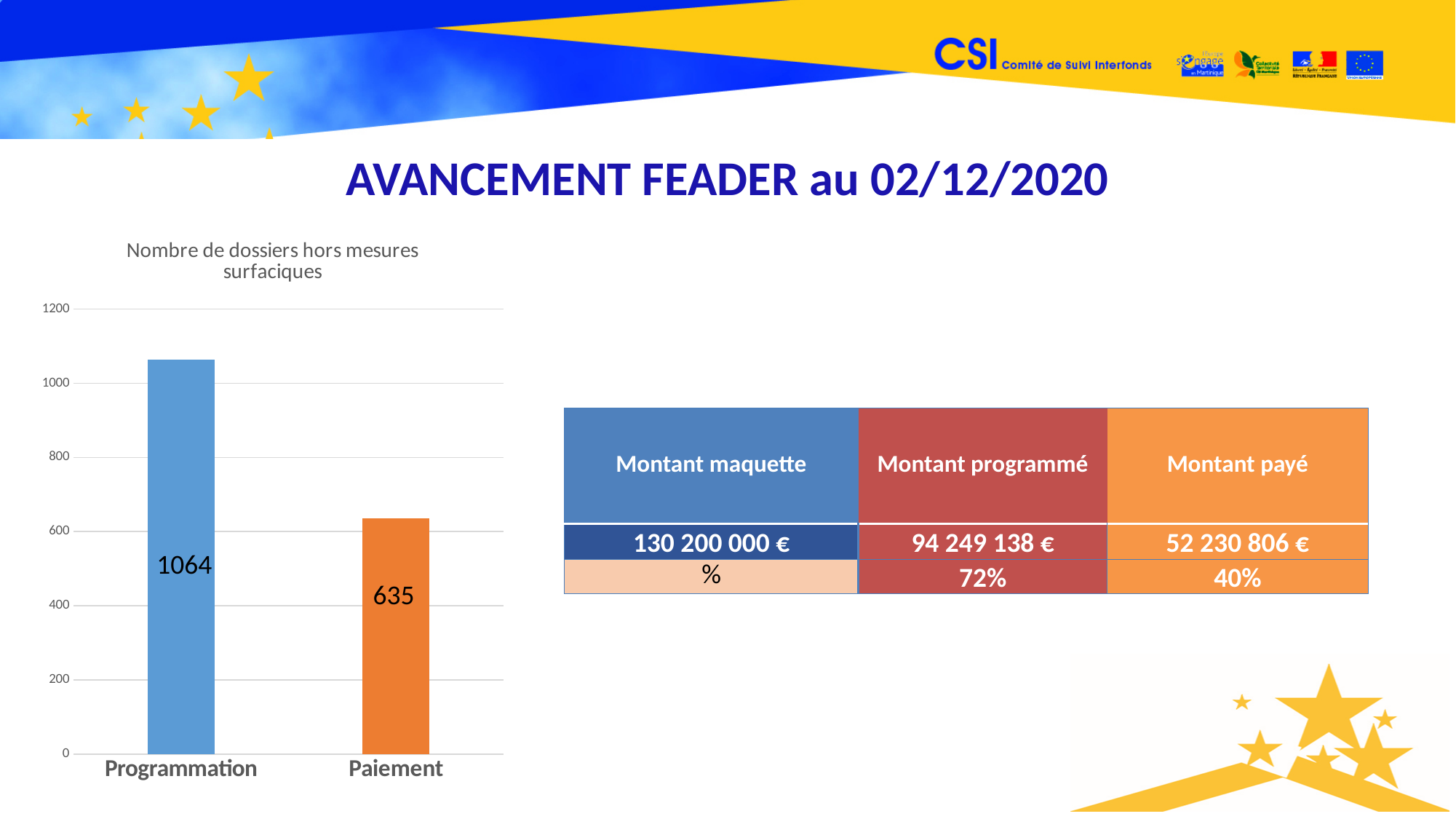
What is the difference between the Programmation and Paiement values in the chart 'Nombre de dossiers hors mesures surfaciques'? 429 What is the highest value shown on the vertical axis of the chart 'Nombre de dossiers hors mesures surfaciques'? 1200 Which category has the highest value in the chart 'Nombre de dossiers hors mesures surfaciques'? Programmation How many categories are shown in the chart 'Nombre de dossiers hors mesures surfaciques'? 2 What is the value for Programmation in the chart 'Nombre de dossiers hors mesures surfaciques'? 1064 In the chart 'Nombre de dossiers hors mesures surfaciques', which is larger: Programmation or Paiement? Programmation Which category has the lowest value in the chart 'Nombre de dossiers hors mesures surfaciques'? Paiement Is the value for Paiement in the chart 'Nombre de dossiers hors mesures surfaciques' greater or less than 800? less Is the value for Programmation in the chart 'Nombre de dossiers hors mesures surfaciques' greater or less than 1000? greater What is the value for Paiement in the chart 'Nombre de dossiers hors mesures surfaciques'? 635 What is the title of the chart on the left of the slide? Nombre de dossiers hors mesures surfaciques What kind of chart is 'Nombre de dossiers hors mesures surfaciques'? Bar chart